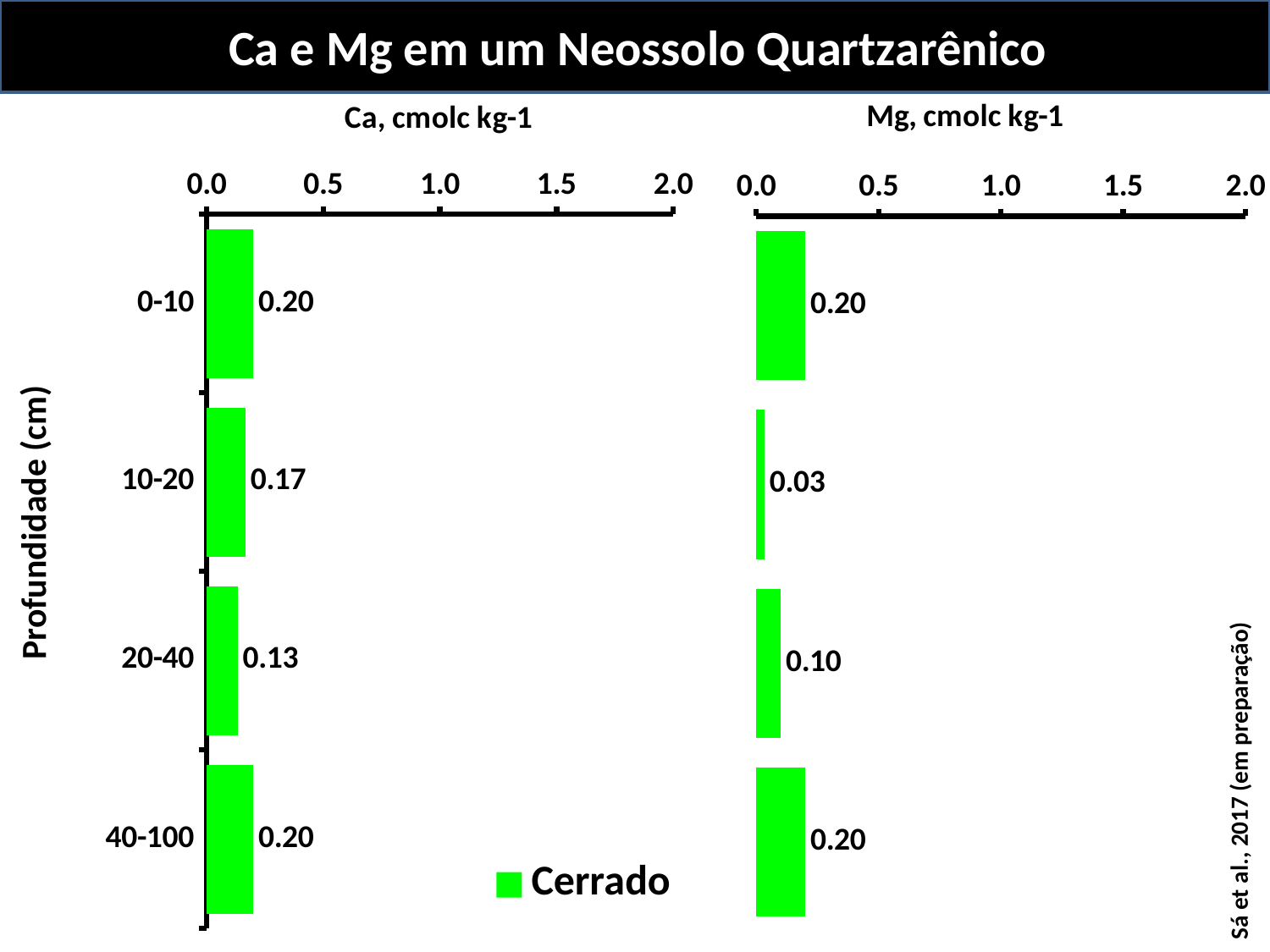
In the Ca chart (left), what is the value for the 10-20 cm depth? 0.17 Which is larger: the Ca value for 10-20 cm or the Mg value for 10-20 cm? Ca value for 10-20 cm What type of chart is used for the Ca chart (left)? Bar chart In the Ca chart (left), what is the value for the 20-40 cm depth? 0.13 How many depth categories are shown in the Mg chart (right)? 4 In the Ca chart (left), what is the difference between the values for 0-10 cm and 20-40 cm? 0.07 In the Ca chart (left), is the value for 0-10 cm greater or less than 0.5? less In the Mg chart (right), what is the difference between the values for 40-100 cm and 10-20 cm? 0.17 In the Mg chart (right), what is the value for the 20-40 cm depth? 0.10 In the Ca chart (left), which depth has the lowest value? 20-40 In the Mg chart (right), which depth has the lowest value? 10-20 In the Mg chart (right), what is the value for the 10-20 cm depth? 0.03